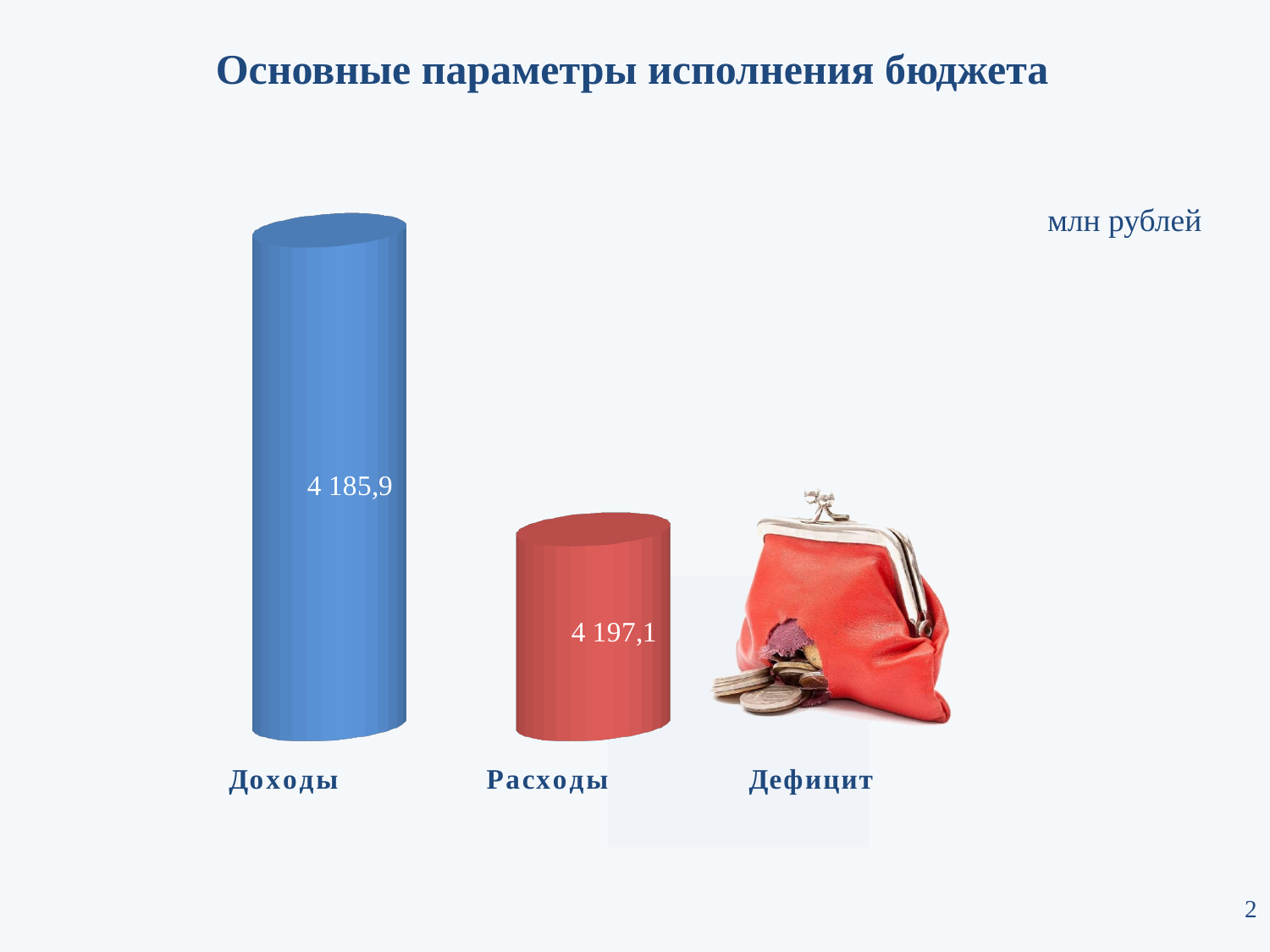
How many categories are shown on the x axis of the chart? 3 What is the difference between the values for Расходы and Доходы? 11,2 Which category is the third one on the x axis? Дефицит What is the title of the slide? Основные параметры исполнения бюджета What kind of chart is shown on the slide? Bar chart In what units are the chart values given, according to the slide? млн рублей What is the value for Доходы? 4 185,9 What is the value for Расходы? 4 197,1